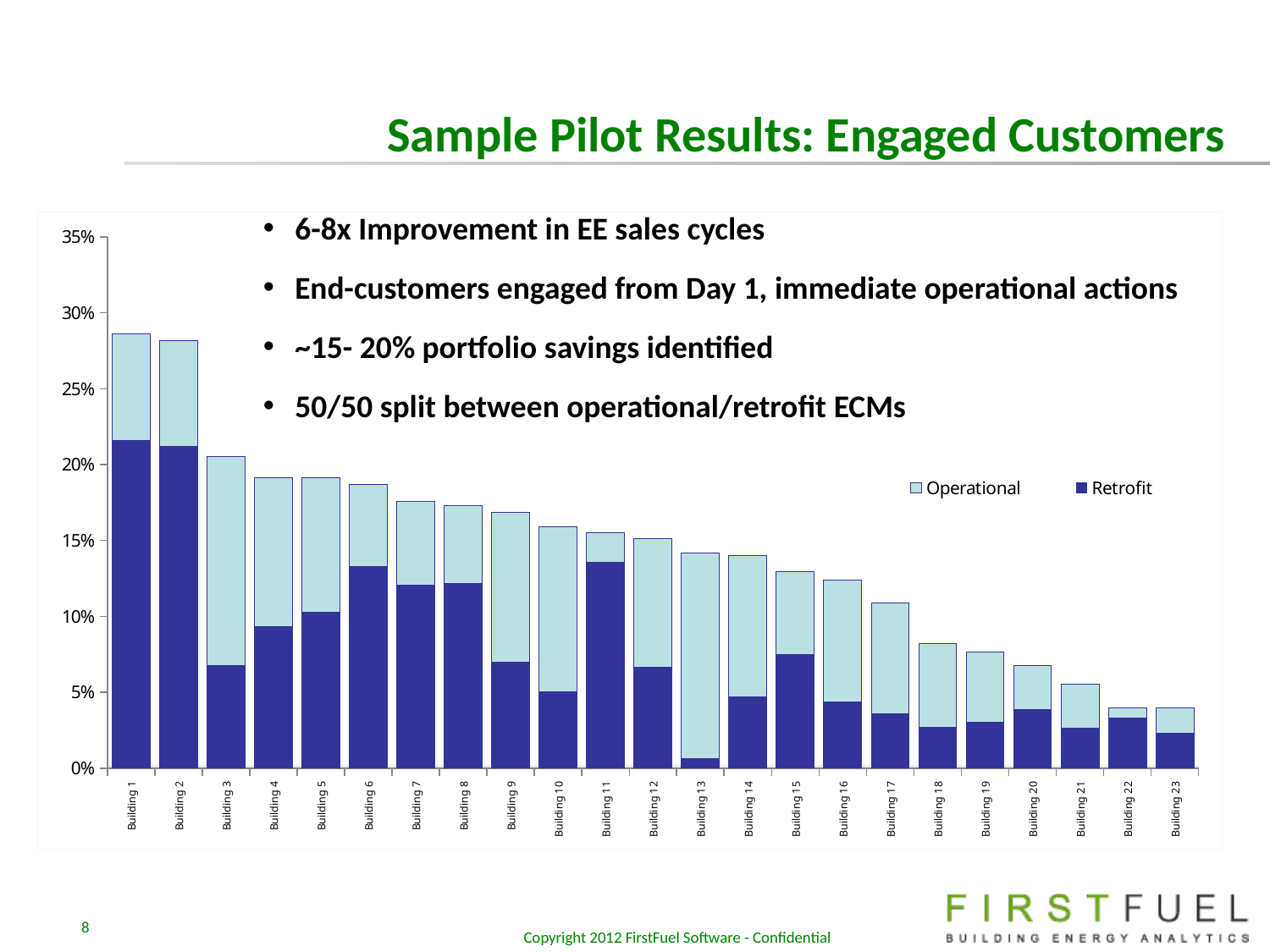
Is the Retrofit value for Building 11 greater or less than 10%? greater Which building has the lowest Retrofit value? Building 13 How many buildings are shown on the x axis of the chart? 23 What kind of chart is shown on the slide? Stacked bar chart Which colour represents the Retrofit series in the chart? Dark blue How many series does the chart's legend list? 2 Is the total value for Building 1 greater or less than 25%? greater Is the total value for Building 23 greater or less than 5%? less What are the two series named in the chart's legend? Operational and Retrofit Which has a larger total value, Building 1 or Building 23? Building 1 Do the total bar heights generally rise or fall from Building 1 to Building 23? fall